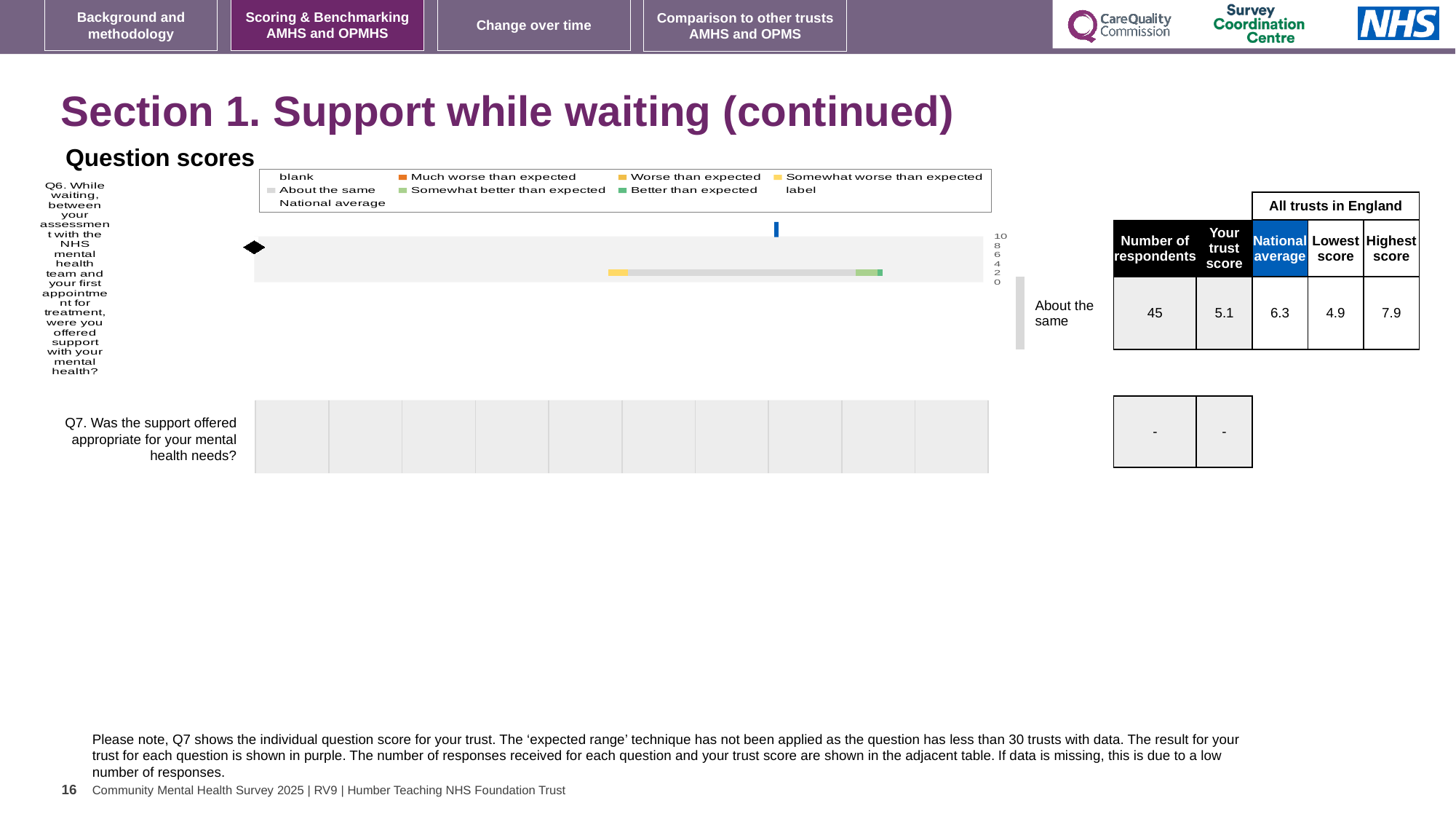
How many questions (categories) are shown in the question scores chart? 2 What is the highest score among all trusts in England for Q6? 7.9 What is the difference between the highest score and the lowest score for Q6? 3.0 What is the lowest score among all trusts in England for Q6? 4.9 What colour does the legend use for 'Better than expected'? green What kind of chart is used to show the question scores on this slide? bar chart What is the number of respondents for Q6 in the table next to the chart? 45 Which expected-range category is shown for Q6 beside the chart? About the same What is the national average for Q6 shown in the table next to the chart? 6.3 Is the trust score for Q6 greater or less than 6? less What is the trust score for Q6 shown in the table next to the chart? 5.1 Which is larger for Q6, the trust score or the national average? national average